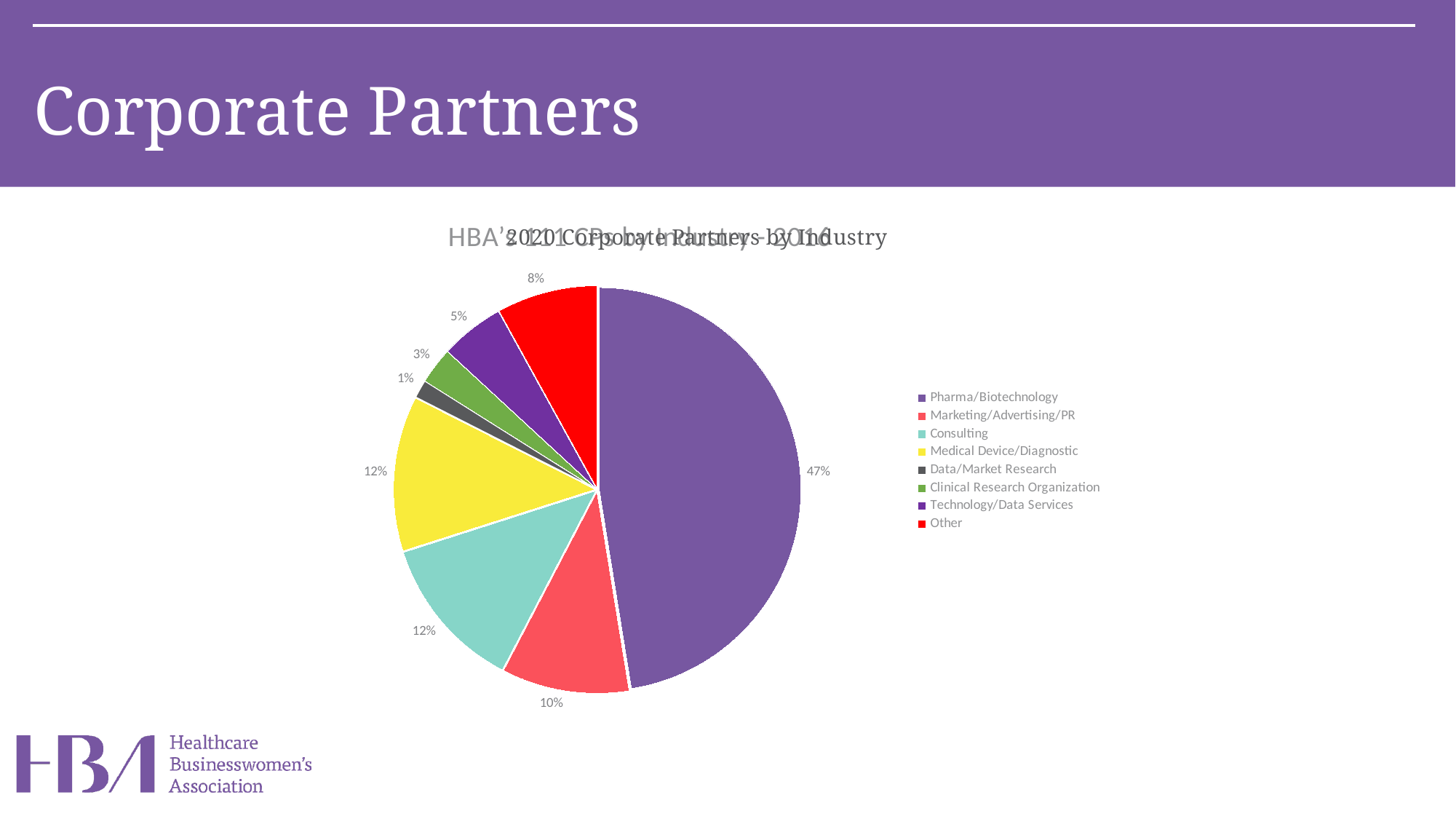
What percentage is shown for the Other category? 8% What share of the pie does Pharma/Biotechnology hold? 47% What colour represents the Other category in the pie chart? Red Which category has the smallest slice of the pie? Data/Market Research Which is larger, the share for Other or the share for Technology/Data Services? Other Which category has the largest slice of the pie? Pharma/Biotechnology What kind of chart is shown on the slide? Pie chart What percentage is shown for Technology/Data Services? 5% What is the difference in percentage points between Pharma/Biotechnology and Consulting? 35 What percentage is shown for Clinical Research Organization? 3% How many categories does the legend list? 8 What percentage is shown for Marketing/Advertising/PR? 10%